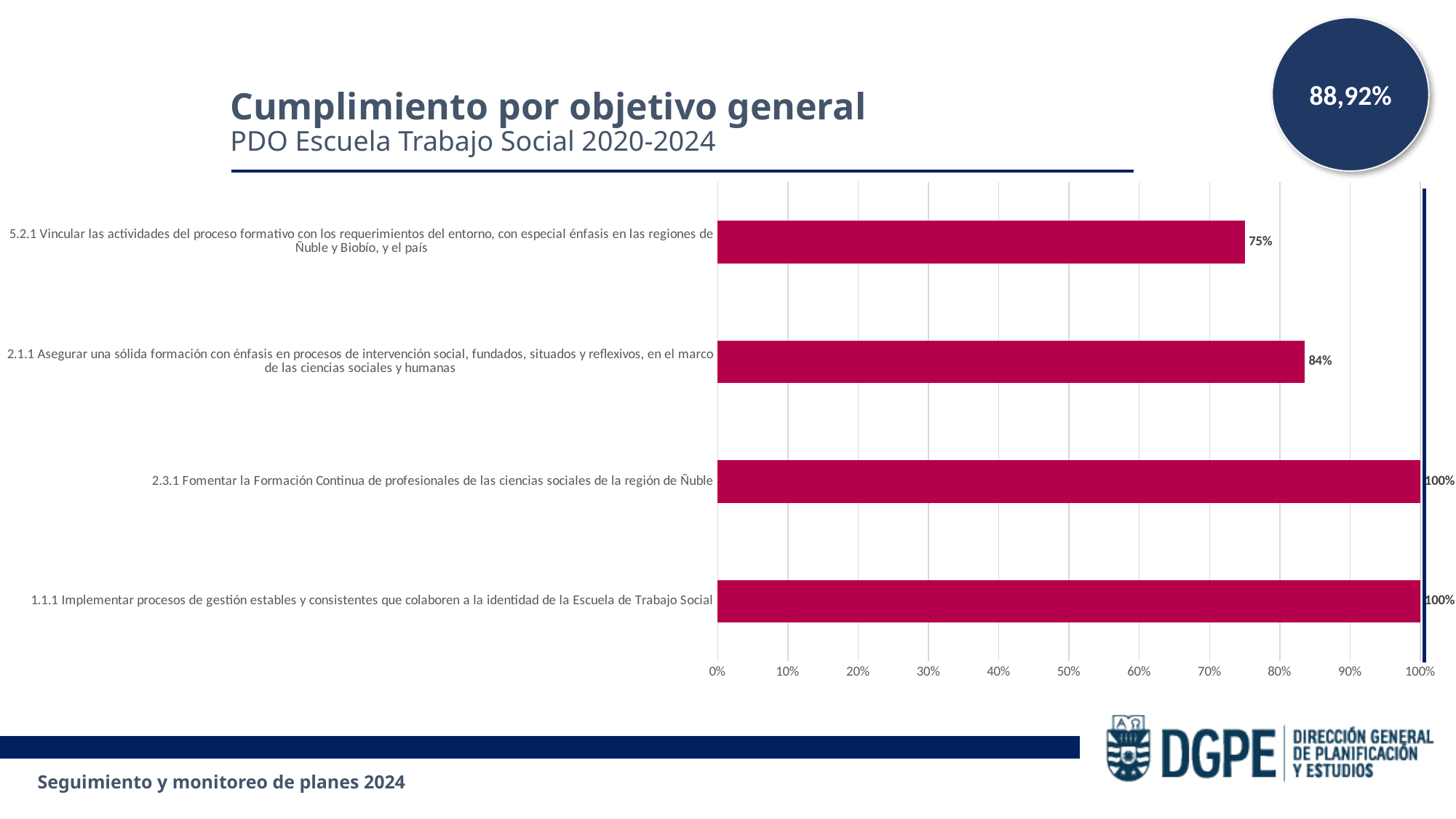
What is the value for objective 5.2.1 (Vincular las actividades del proceso formativo con los requerimientos del entorno)? 75% What is the value for objective 1.1.1 (Implementar procesos de gestión estables y consistentes)? 100% Which is larger, the value for objective 2.1.1 or the value for objective 5.2.1? 2.1.1 How many objectives (bars) are shown in the chart? 4 Which objective has the lowest value in the chart? 5.2.1 Vincular las actividades del proceso formativo con los requerimientos del entorno, con especial énfasis en las regiones de Ñuble y Biobío, y el país What is the value for objective 2.3.1 (Fomentar la Formación Continua de profesionales de las ciencias sociales de la región de Ñuble)? 100% What kind of chart is shown on the slide? Bar chart Is the value for objective 5.2.1 greater or less than 80%? less What is the title of the chart on the slide? Cumplimiento por objetivo general What is the difference between the values for objective 2.3.1 and objective 2.1.1? 16% What is the value for objective 2.1.1 (Asegurar una sólida formación con énfasis en procesos de intervención social)? 84% What is the difference between the values for objective 2.1.1 and objective 5.2.1? 9%